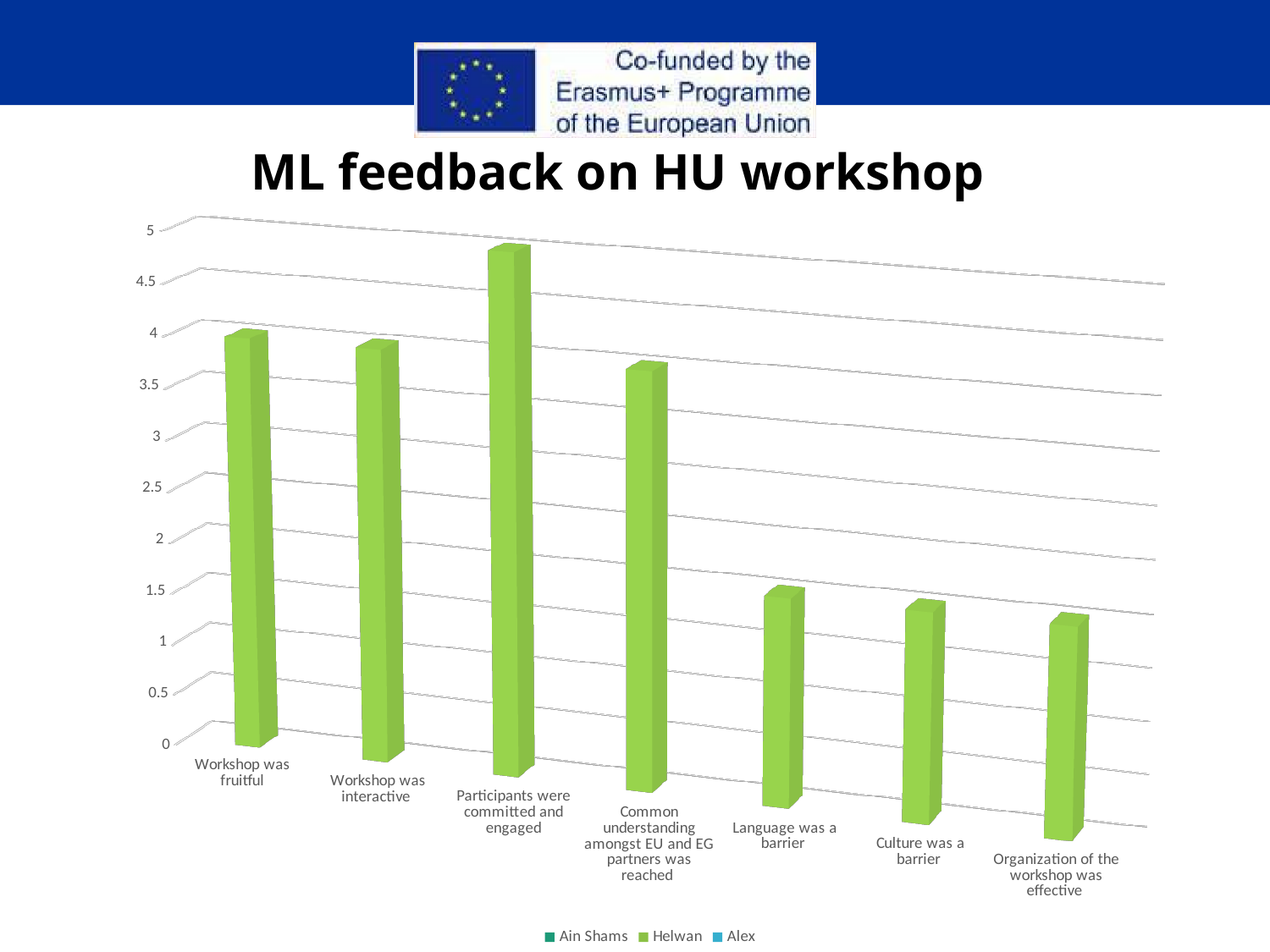
Which is larger, the value for 'Participants were committed and engaged' or the value for 'Common understanding amongst EU and EG partners was reached'? Participants were committed and engaged Is the value for 'Participants were committed and engaged' greater or less than 4.5? greater Is the value for 'Language was a barrier' greater or less than 3? less Is the value for 'Workshop was fruitful' greater or less than 3? greater How many series does the chart legend list? 3 What is the title of the chart? ML feedback on HU workshop How many categories are shown on the x axis of the chart? 7 Which series in the legend is shown in light green? Helwan What kind of chart is shown on the slide? Bar chart Which category has the highest bar in the chart? Participants were committed and engaged Which is larger, the value for 'Workshop was fruitful' or the value for 'Culture was a barrier'? Workshop was fruitful